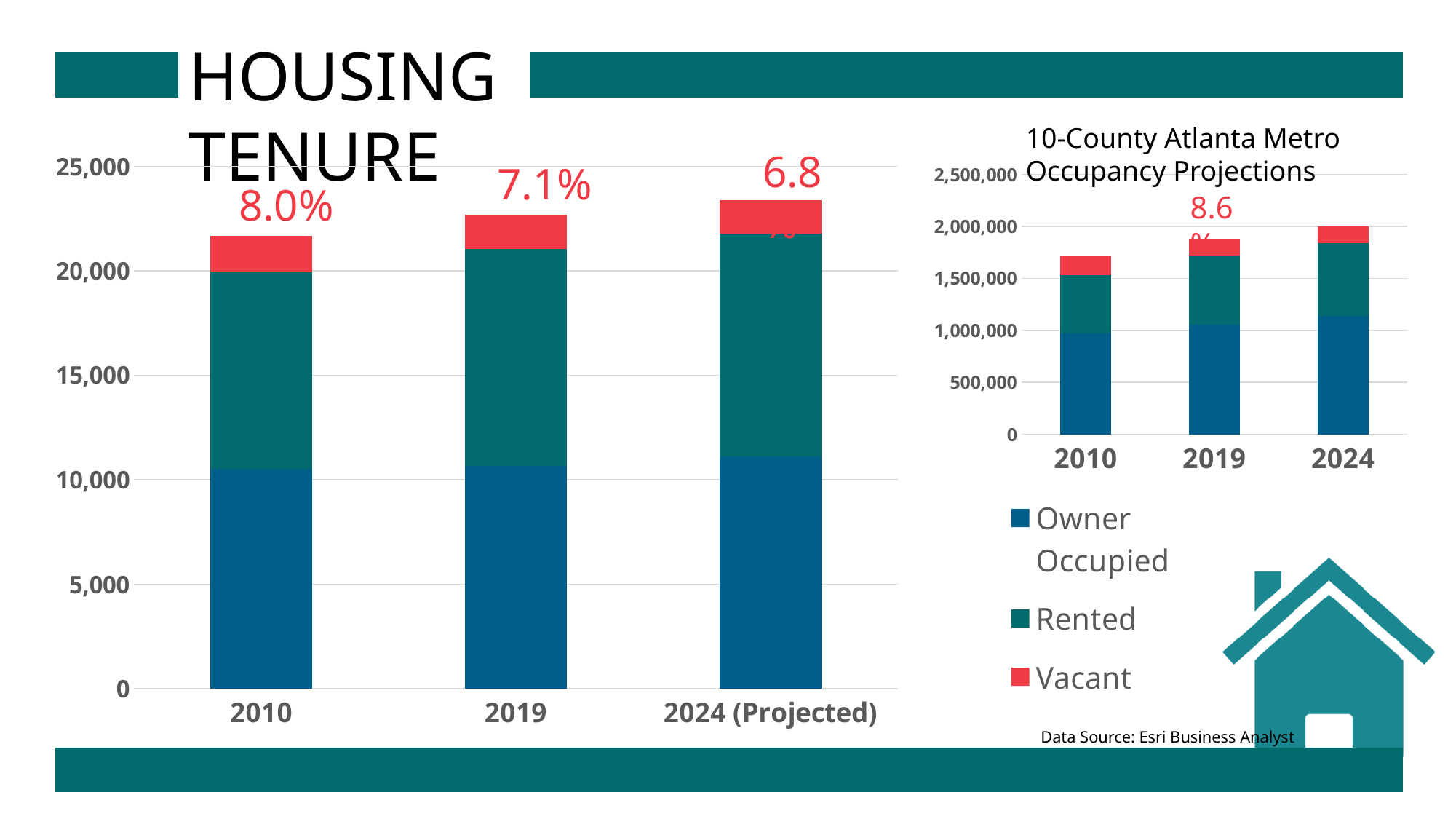
On the left chart, is the total height of the 2019 bar greater or less than 25,000? less On the left chart, what vacancy rate label is shown above the 2010 bar? 8.0% What kind of chart is the left chart? Stacked bar chart On the left chart, which year has the tallest total bar? 2024 (Projected) On the 10-County Atlanta Metro Occupancy Projections chart, is the total height of the 2010 bar greater or less than 1,500,000? greater On the left chart, is the total height of the 2010 bar greater or less than 20,000? greater On the left chart, do the total bar heights rise or fall from 2010 to 2024 (Projected)? rise On the left chart, how many year categories are shown on the x axis? 3 What data source is cited on the slide? Esri Business Analyst On the left chart, what vacancy rate label is shown above the 2019 bar? 7.1% How many series does the legend list? 3